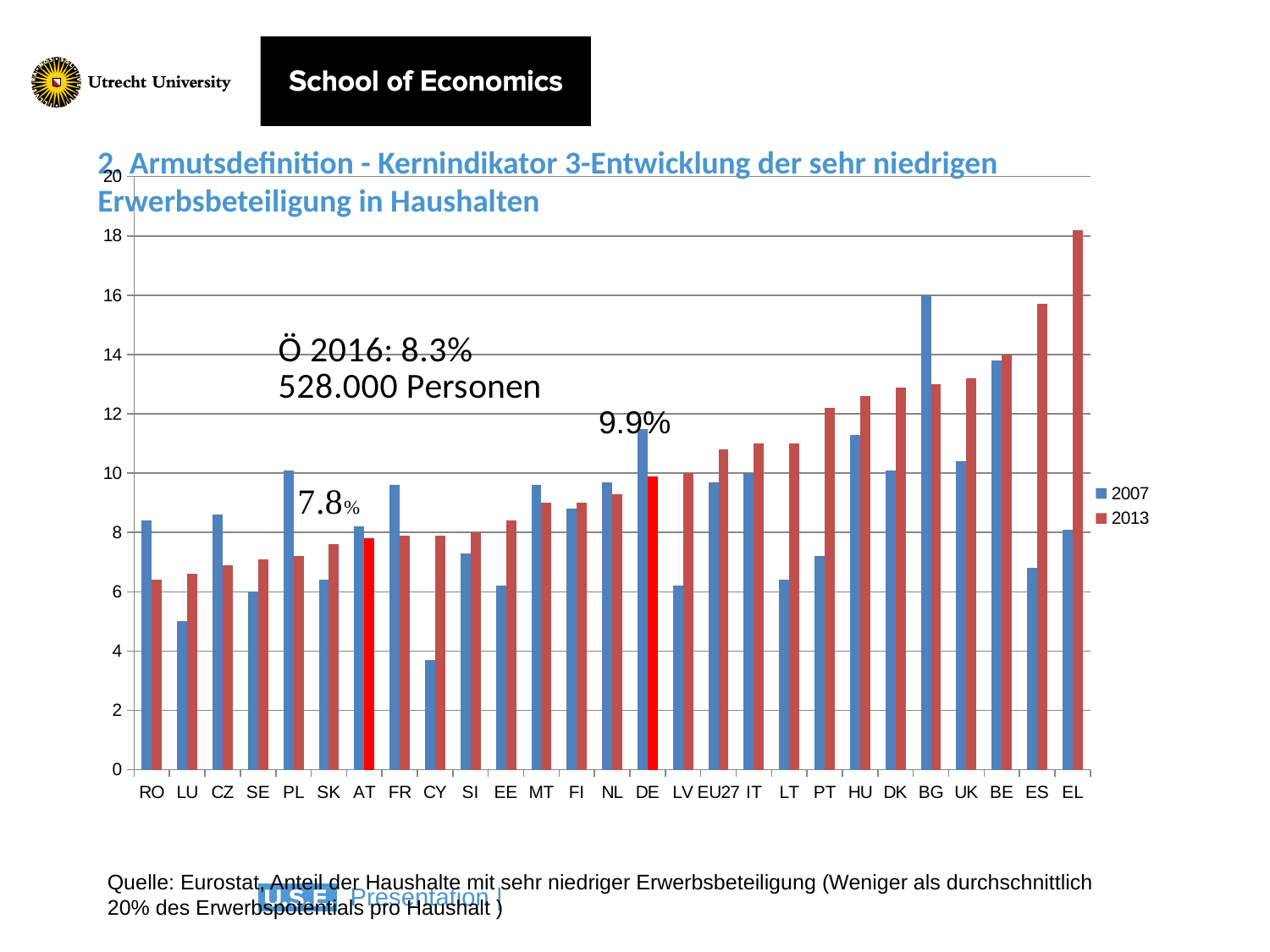
Which category has the lowest 2007 value? CY How many series does the legend list? 2 For ES, which is larger: the 2007 value or the 2013 value? 2013 What kind of chart is shown on the slide? bar chart Which colour represents the 2007 series in the legend? blue Is the 2013 value for EL greater or less than 16? greater Which category has the highest 2013 value? EL What value is labelled for AT (Austria) in 2013? 7.8% What value is labelled for DE (Germany) in 2013? 9.9% What is the difference between the labelled 2013 values for DE and AT? 2.1% How many countries/categories are shown on the x axis? 27 Which category has the highest 2007 value? BG